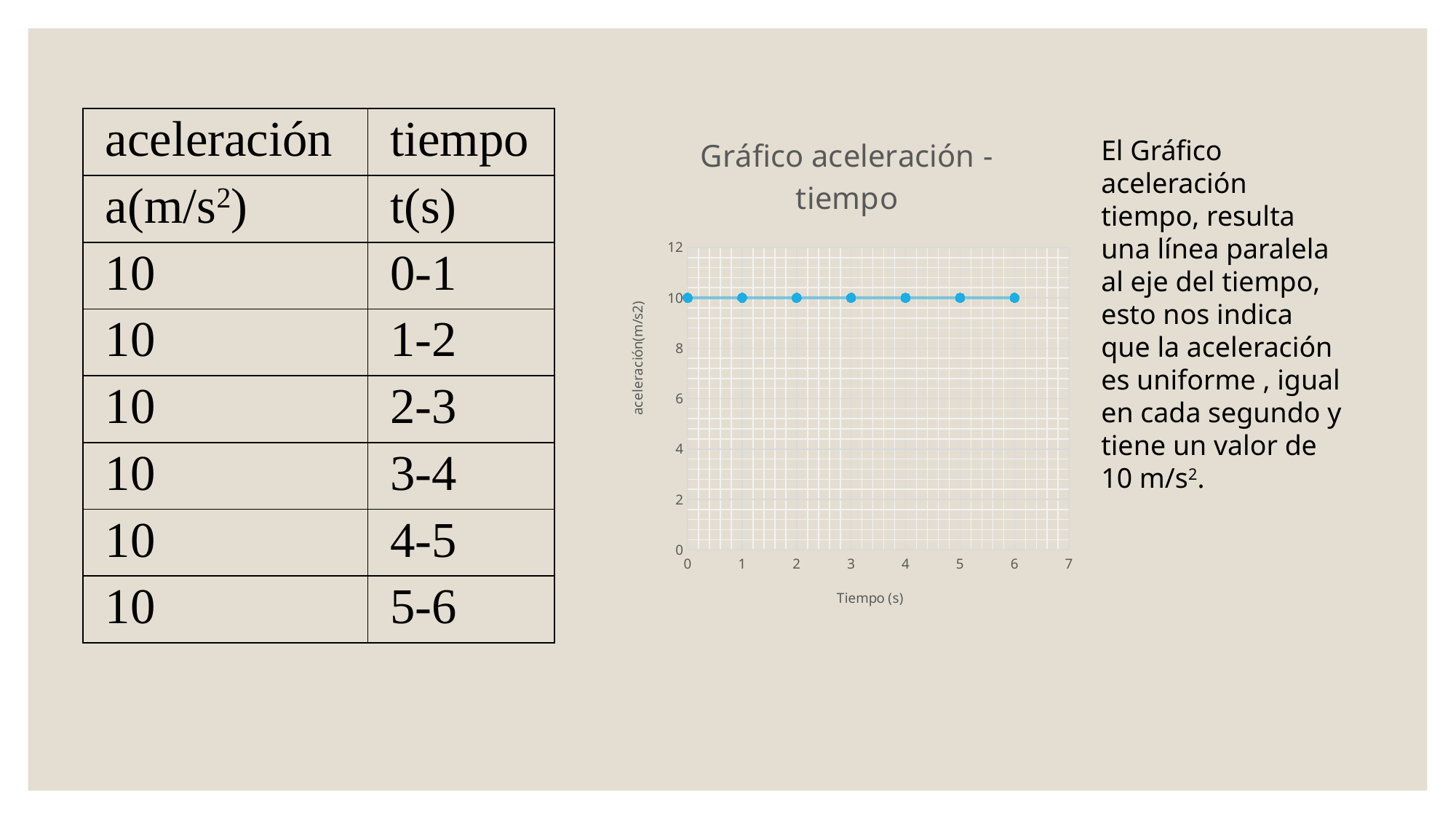
What kind of chart is shown on the slide? line chart How many data points are plotted on the chart? 7 Is the value plotted at time 2 s greater or less than 8? greater What is the title of the chart? Gráfico aceleración - tiempo What is the acceleration value plotted at time 0 s? 10 What is the acceleration value plotted at time 3 s? 10 What is the acceleration value plotted at time 6 s? 10 What is the label of the x axis? Tiempo (s) What is the difference between the values plotted at time 1 s and time 4 s? 0 What is the highest value shown on the y axis? 12 Is the value plotted at time 5 s greater or less than 12? less Do the plotted values rise, fall, or stay constant as time increases? stay constant